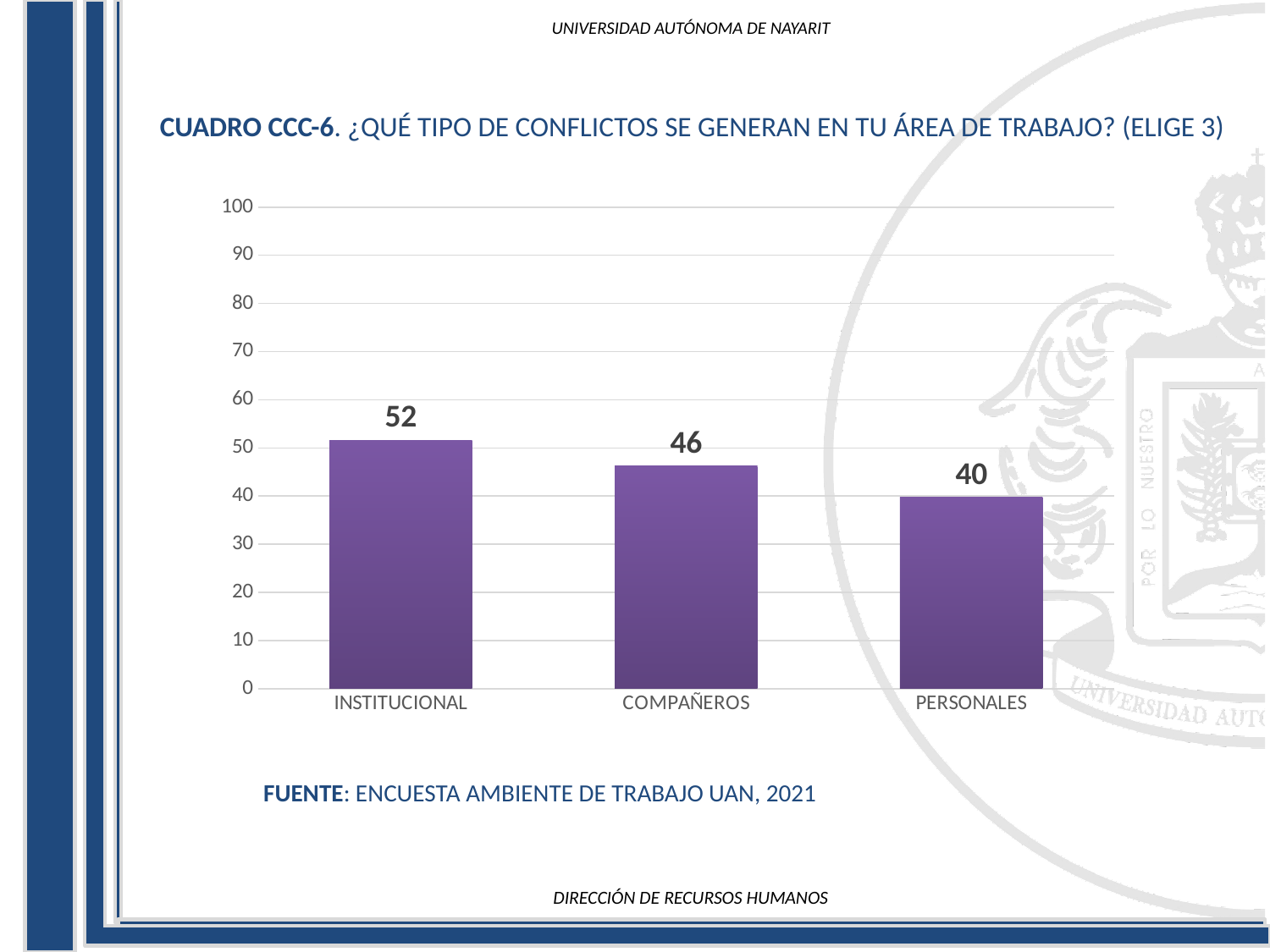
What is the value for INSTITUCIONAL? 52 How many categories are shown on the x axis? 3 Which is larger, the value for INSTITUCIONAL or the value for COMPAÑEROS? INSTITUCIONAL What is the value for PERSONALES? 40 What is the value for COMPAÑEROS? 46 What kind of chart is shown on the slide? bar chart Which category has the lowest value? PERSONALES What is the difference between the values for INSTITUCIONAL and PERSONALES? 12 Do the values rise or fall from left to right along the x axis? fall What is the difference between the values for COMPAÑEROS and PERSONALES? 6 Is the value for COMPAÑEROS greater or less than 50? less Which category has the highest value? INSTITUCIONAL